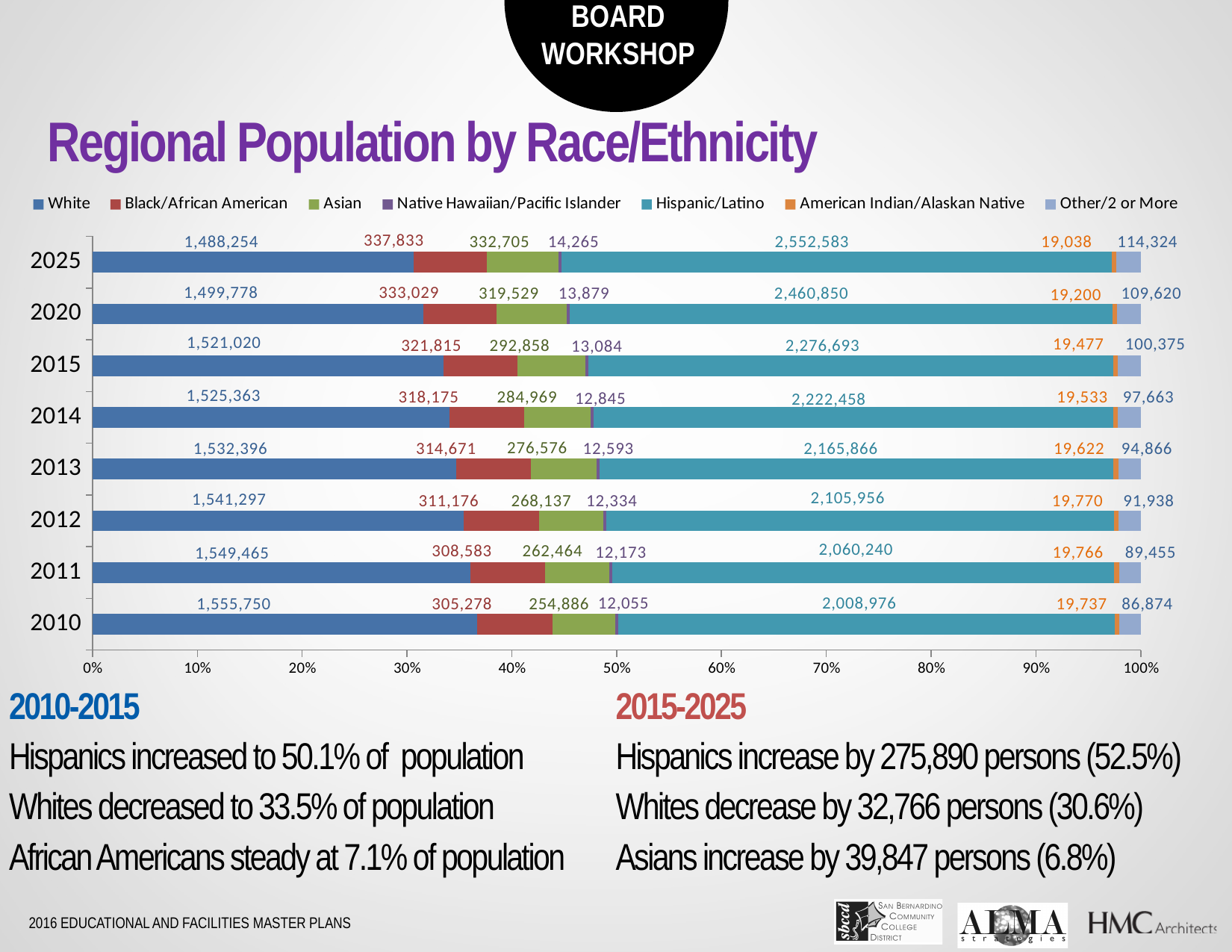
How many series does the legend list? 7 How many years are shown on the chart? 8 What is the difference between the Hispanic/Latino values for 2025 and 2015? 275,890 What is the American Indian/Alaskan Native value shown for 2014? 19,533 What is the White population value shown for 2025? 1,488,254 Do the White population values rise or fall from 2010 to 2025? Fall In 2020, which is larger: the Black/African American value or the Asian value? Black/African American Which year has the lowest White value? 2025 Which year has the highest Hispanic/Latino value? 2025 What is the Hispanic/Latino population value shown for 2010? 2,008,976 What is the Asian population value shown for 2015? 292,858 What kind of chart is shown on the slide? Stacked bar chart